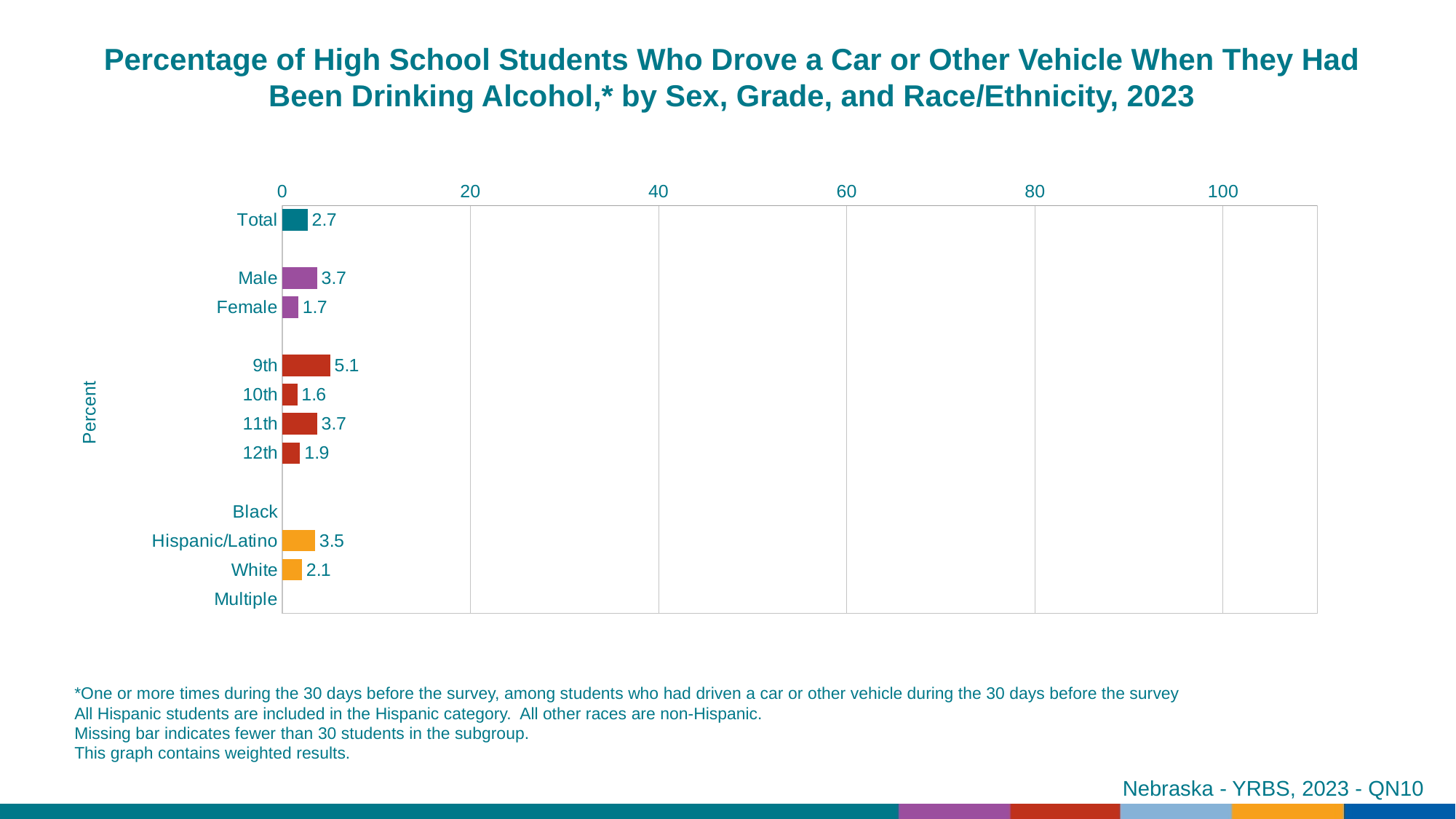
What is the value for 9th grade? 5.1 How many categories have a bar plotted? 9 What is the value for Total? 2.7 What kind of chart is shown? bar chart What is the difference between the Male and Female values? 2.0 Which is larger, the value for Hispanic/Latino or the value for White? Hispanic/Latino Which race/ethnicity categories have no bar shown? Black and Multiple What is the value for Hispanic/Latino? 3.5 Which grade has the highest value? 9th What is the value for Male? 3.7 Which grade has the lowest value? 10th Is the value for 9th grade greater or less than 20? less